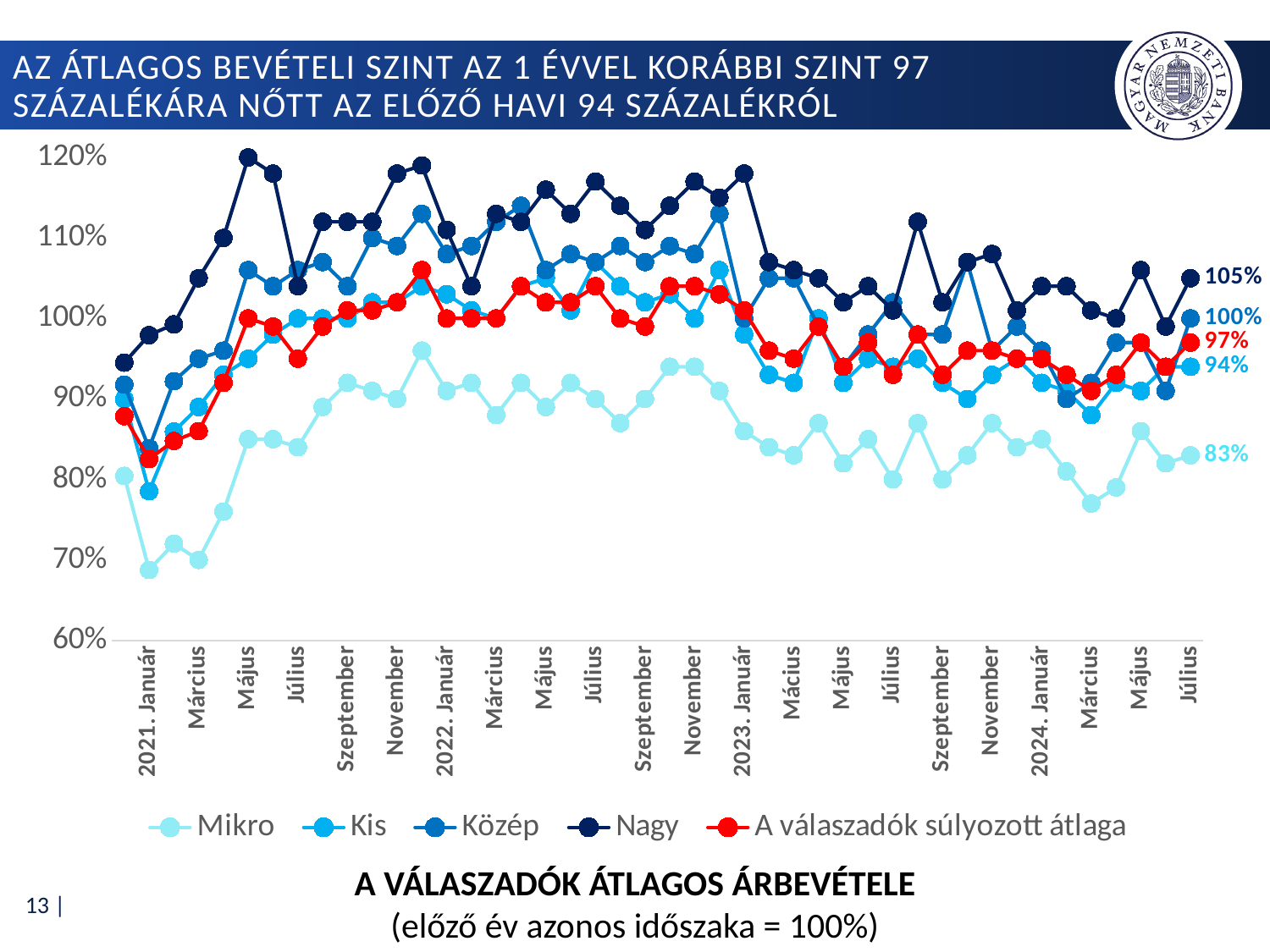
What is the value of the Nagy series at the last point (2024 Július)? 105% At the last point (2024 Július), what is the difference between the Nagy and Mikro values? 22 percentage points What is the value of the Közép series at the last point (2024 Július)? 100% What is the value of 'A válaszadók súlyozott átlaga' at the last point (2024 Július)? 97% Is the value for Mikro in 2021. Január greater or less than 90%? less What is the value of the Mikro series at the last point (2024 Július)? 83% Which series has the lowest value at the last point (2024 Július)? Mikro Which series has the highest value at the last point (2024 Július)? Nagy How many series does the legend list? 5 What is the title shown below the chart? A VÁLASZADÓK ÁTLAGOS ÁRBEVÉTELE What kind of chart is shown on the slide? line chart What is the value of the Kis series at the last point (2024 Július)? 94%